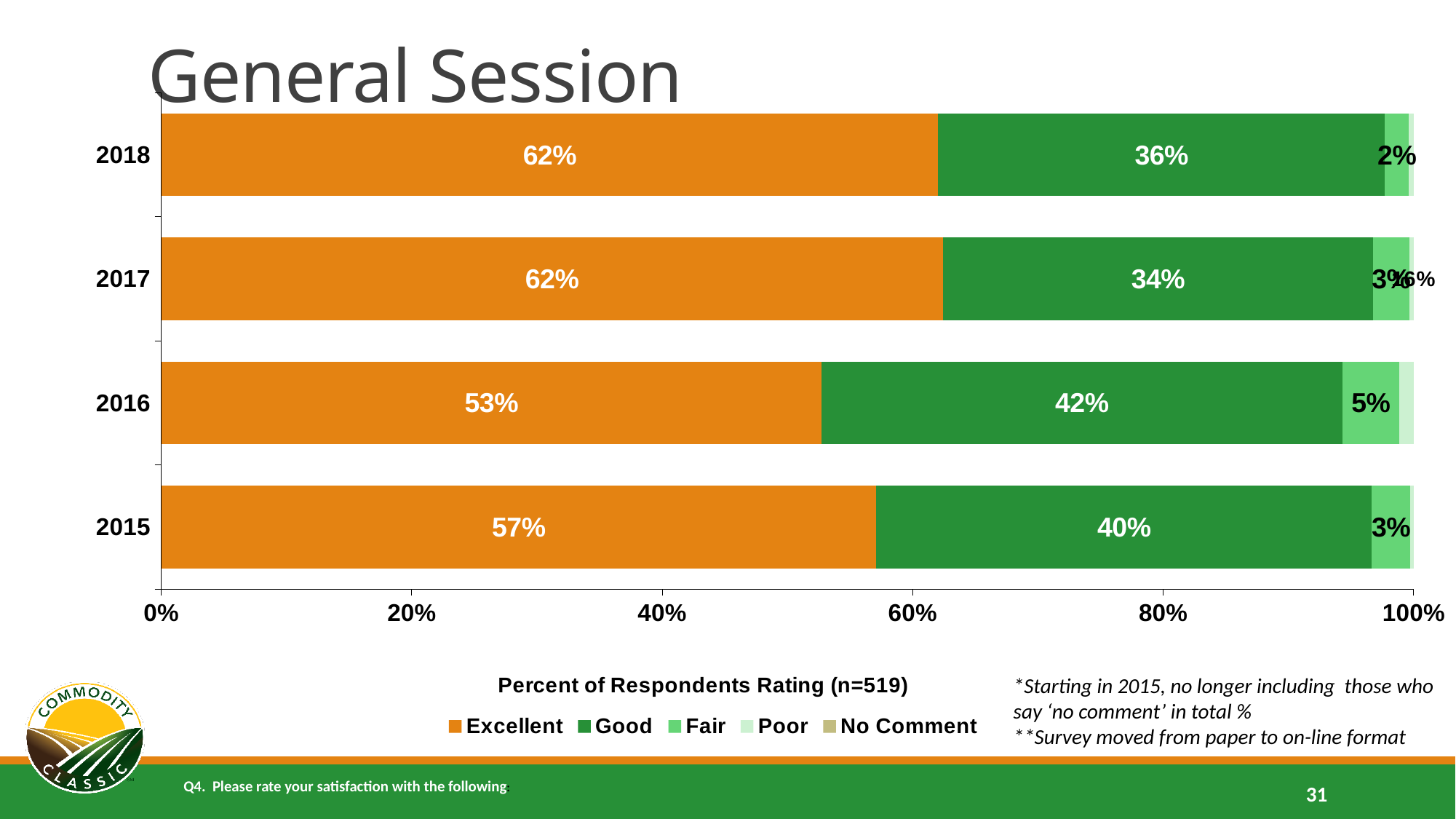
What kind of chart is shown on the slide? stacked bar chart What percentage of respondents rated the General Session as Good in 2016? 42% How many series does the legend list? 5 Which year has the highest Good rating? 2016 How many years are shown on the chart? 4 Is the Good rating larger in 2015 or in 2017? 2015 What percentage of respondents rated the General Session as Excellent in 2018? 62% What is the sample size (n) stated in the legend title? 519 What percentage of respondents rated the General Session as Fair in 2016? 5% What percentage of respondents rated the General Session as Excellent in 2015? 57% What is the difference between the Excellent rating in 2018 and the Excellent rating in 2016? 9% Which year has the lowest Excellent rating? 2016